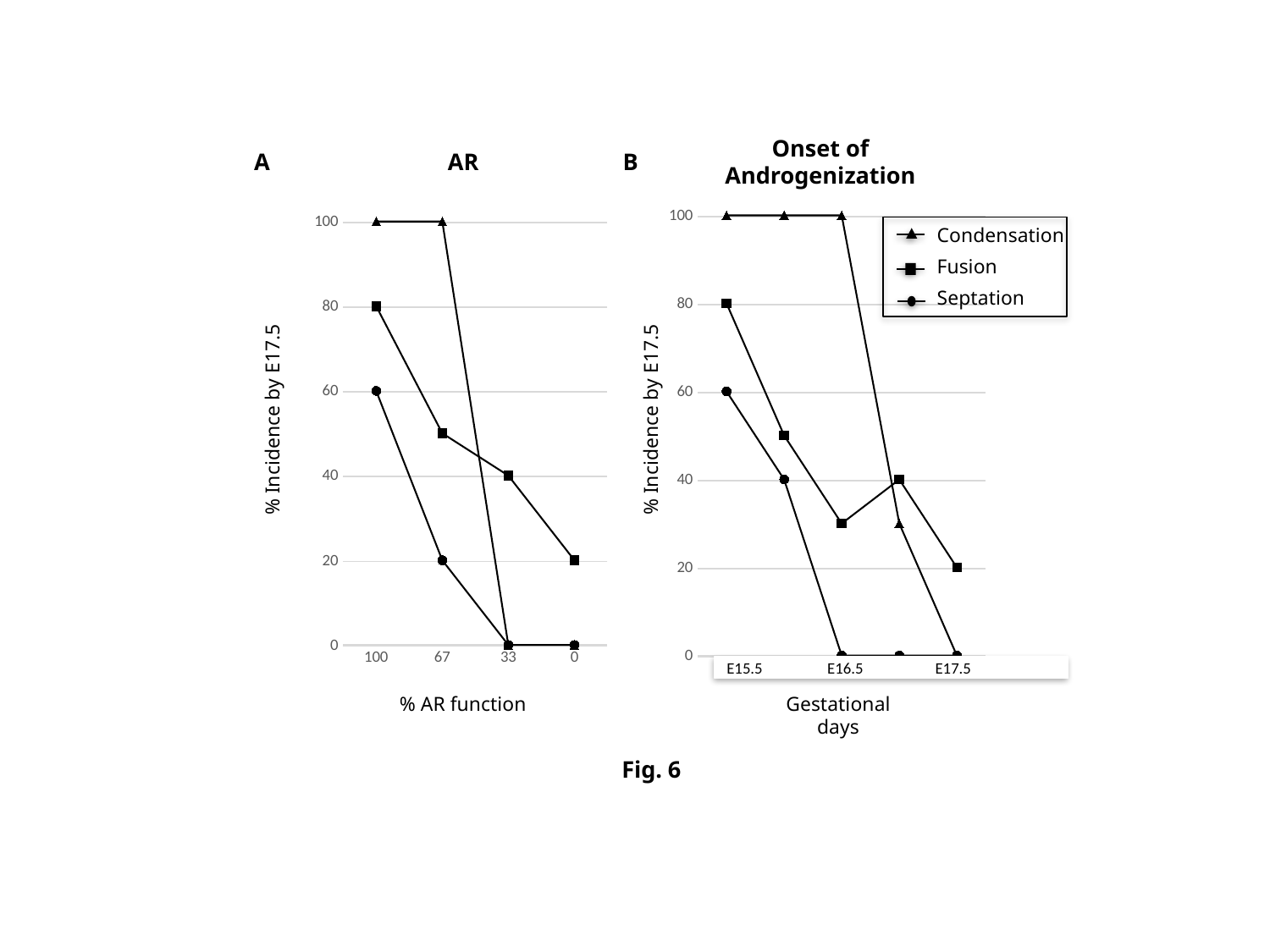
What type of chart is the chart titled "AR"? line chart In the chart titled "Onset of Androgenization", what is the value for Condensation at E16.5? 100 In the chart titled "Onset of Androgenization", which is larger at E15.5, Fusion or Septation? Fusion In the chart titled "Onset of Androgenization", what is the value for Fusion at E17.5? 20 In the chart titled "AR", which series has the highest value at 33% AR function? Fusion How many series does the legend list for the chart titled "Onset of Androgenization"? 3 In the chart titled "AR", what is the value for Fusion at 100% AR function? 80 In the chart titled "AR", what is the value for Fusion at 0% AR function? 20 In the chart titled "AR", does the Septation series rise or fall from 100 to 33 on the x axis? fall In the chart titled "AR", is the value for Fusion at 67% AR function greater or less than 40? greater In the chart titled "AR", what is the difference between Fusion and Septation at 100% AR function? 20 In the chart titled "AR", what is the value for Septation at 100% AR function? 60